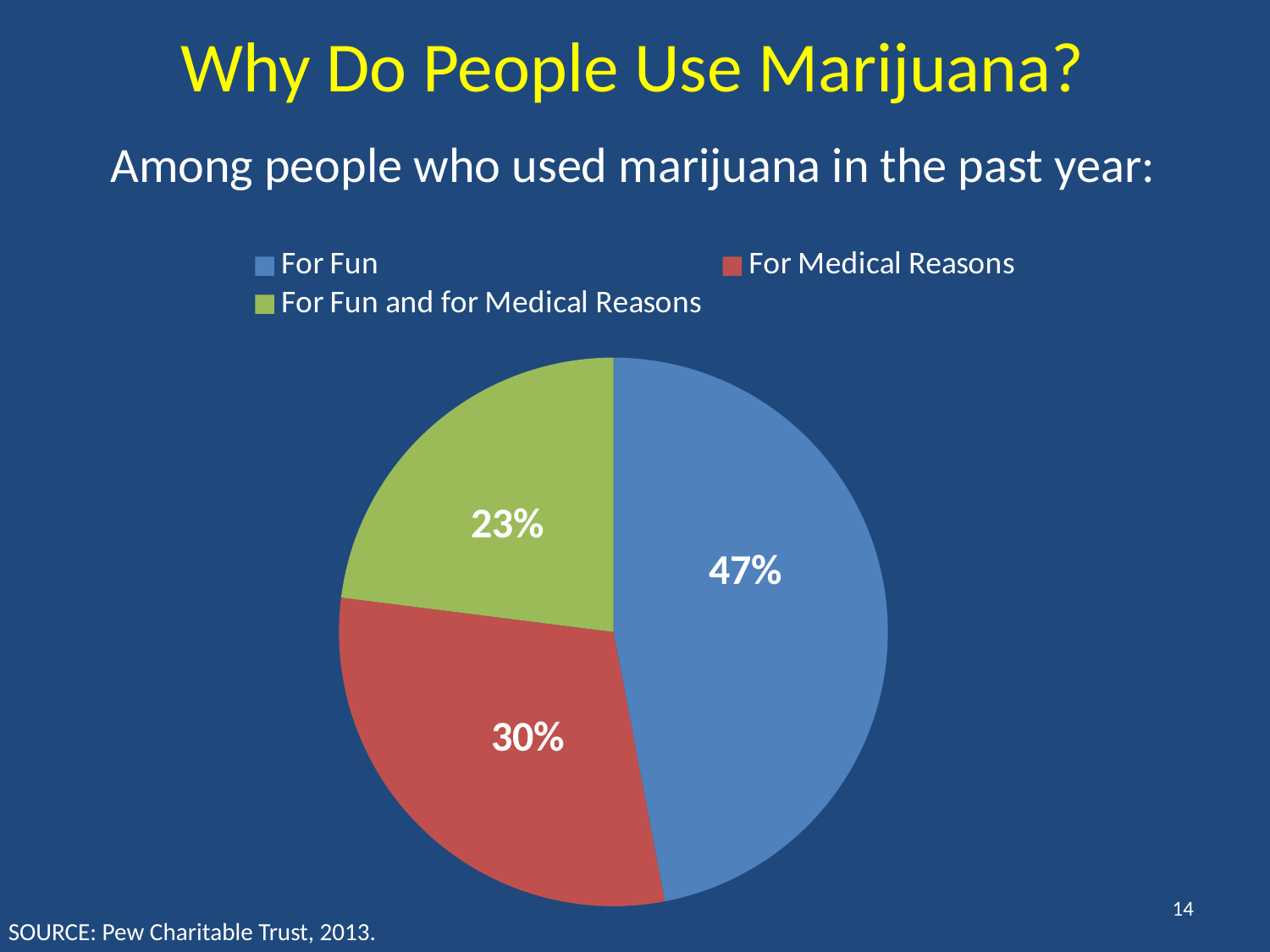
What percentage of past-year marijuana users used it for medical reasons? 30% Which reason has the smallest share of the pie? For Fun and for Medical Reasons How many slices does the pie chart have? 3 What percentage of past-year marijuana users used it for fun and for medical reasons? 23% What kind of chart is shown on the slide? pie chart What colour is the For Medical Reasons slice? red What is the difference in percentage points between the For Fun slice and the For Medical Reasons slice? 17 What percentage of past-year marijuana users used it for fun? 47% Which reason has the largest share of the pie? For Fun Which is larger: the share for For Medical Reasons or the share for For Fun and for Medical Reasons? For Medical Reasons What is the title of the slide containing the pie chart? Why Do People Use Marijuana? How many entries does the legend list? 3